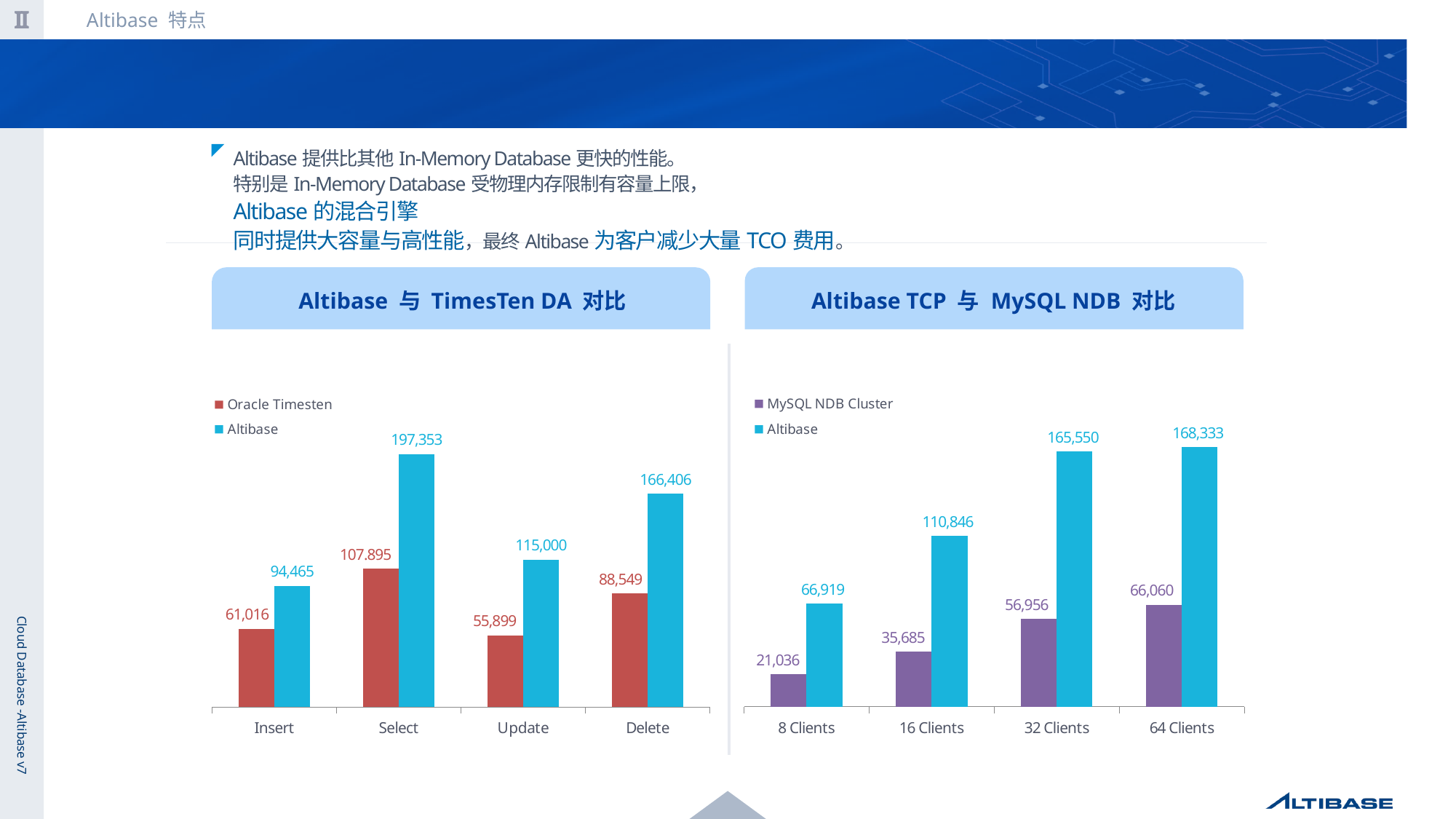
In the right chart (Altibase TCP 与 MySQL NDB 对比), what is the MySQL NDB Cluster value for 32 Clients? 56,956 In the left chart (Altibase 与 TimesTen DA 对比), what is the Altibase value for Select? 197,353 In the left chart (Altibase 与 TimesTen DA 对比), what is the difference between the Altibase and Oracle Timesten values for Delete? 77,857 In the right chart (Altibase TCP 与 MySQL NDB 对比), do the Altibase values rise or fall as the number of clients increases? rise In the right chart (Altibase TCP 与 MySQL NDB 对比), which category has the lowest MySQL NDB Cluster value? 8 Clients In the right chart (Altibase TCP 与 MySQL NDB 对比), how many categories are shown on the x axis? 4 In the left chart (Altibase 与 TimesTen DA 对比), which category has the lowest Oracle Timesten value? Update In the right chart (Altibase TCP 与 MySQL NDB 对比), what is the Altibase value for 16 Clients? 110,846 In the left chart (Altibase 与 TimesTen DA 对比), which category has the highest Altibase value? Select What kind of chart is the right chart (Altibase TCP 与 MySQL NDB 对比)? bar chart In the left chart (Altibase 与 TimesTen DA 对比), what is the Oracle Timesten value for Update? 55,899 In the left chart (Altibase 与 TimesTen DA 对比), how many series does the legend list? 2